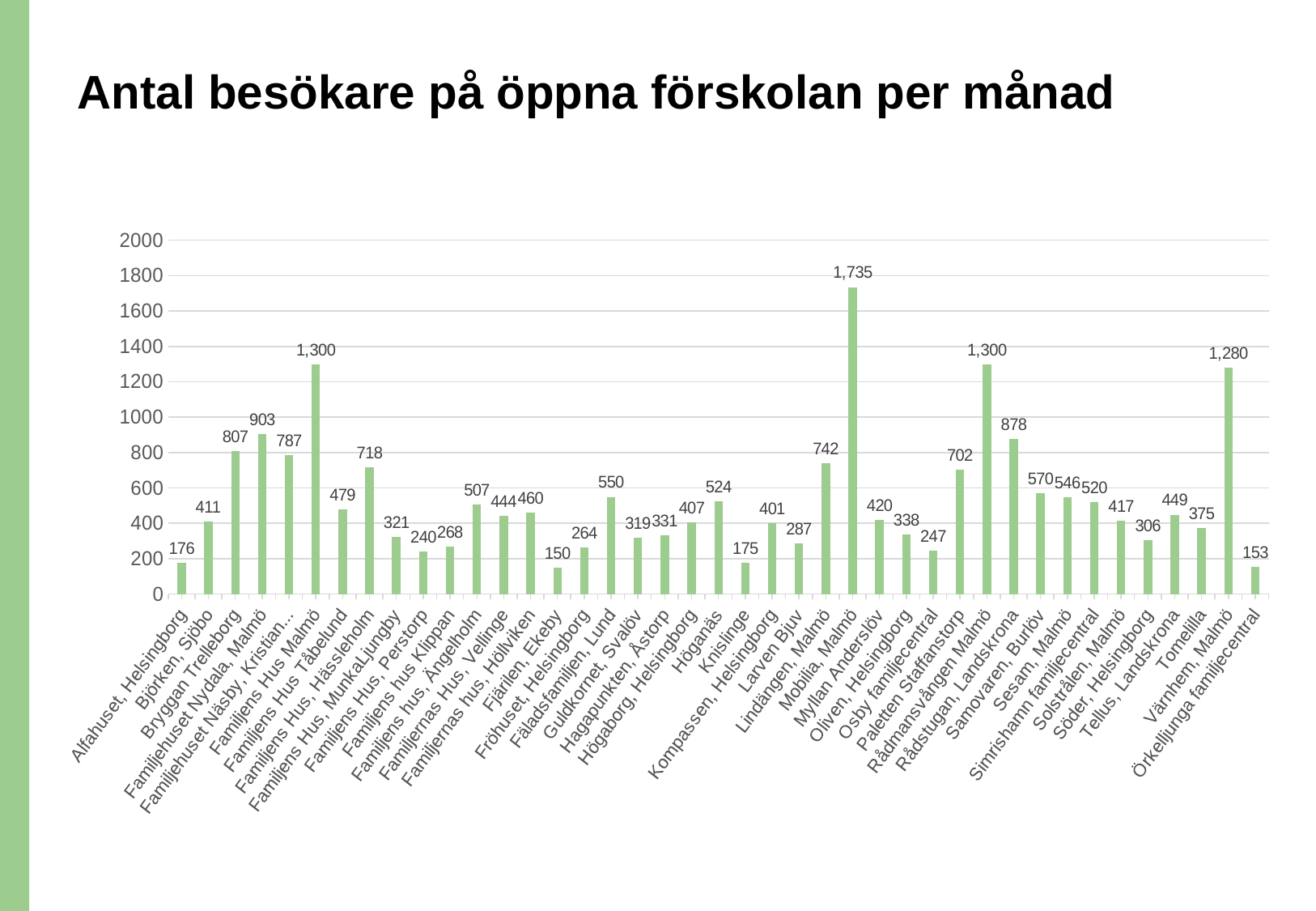
Is the value for Paletten Staffanstorp greater or less than 600? greater Which has a higher value, Bryggan Trelleborg or Familjehuset Nydala, Malmö? Familjehuset Nydala, Malmö What is the number of visitors for Mobilia, Malmö? 1,735 What is the difference between the values for Mobilia, Malmö and Värnhem, Malmö? 455 What kind of chart is shown on the slide? Bar chart Which category has the highest number of visitors? Mobilia, Malmö How many categories are shown on the x axis? 41 What is the title of the chart? Antal besökare på öppna förskolan per månad What is the value shown for Rådstugan, Landskrona? 878 What is the value shown for Familjens Hus, Hässleholm? 718 What is the difference between the values for Rådstugan, Landskrona and Lindängen, Malmö? 136 Which category has the lowest number of visitors? Fjärilen, Ekeby